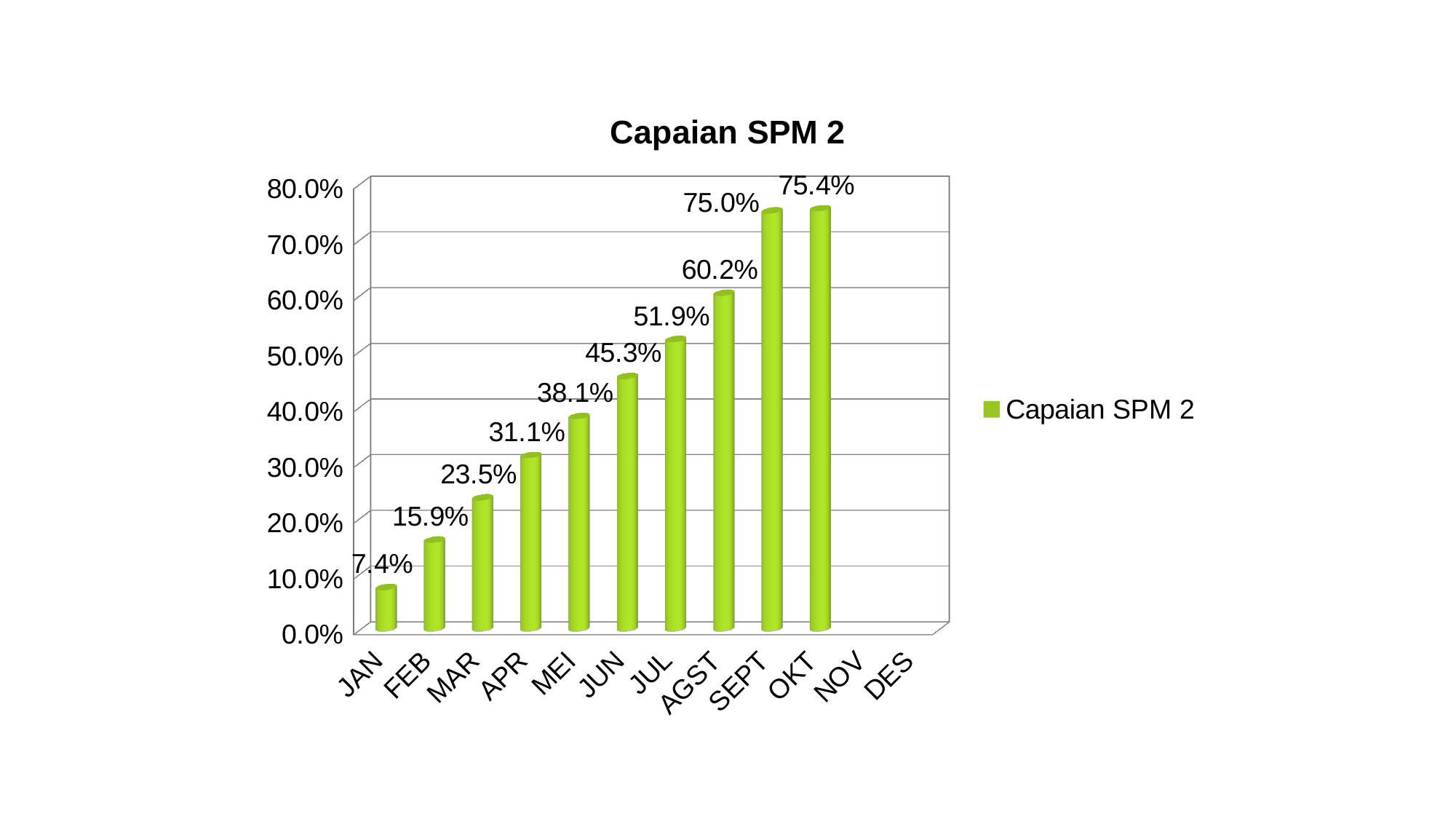
What is the value for JUL? 51.9% How many series does the legend list? 1 What is the value for MAR? 23.5% What is the difference between the values for AGST and JUN? 14.9% How many months have a bar plotted? 10 Which is larger, the value for APR or the value for MEI? MEI Do the values rise or fall from JAN to OKT? rise Is the value for JUN greater or less than 40.0%? greater Which month has the highest value? OKT What is the value for SEPT? 75.0% What kind of chart is shown? bar chart Which month has the lowest value? JAN